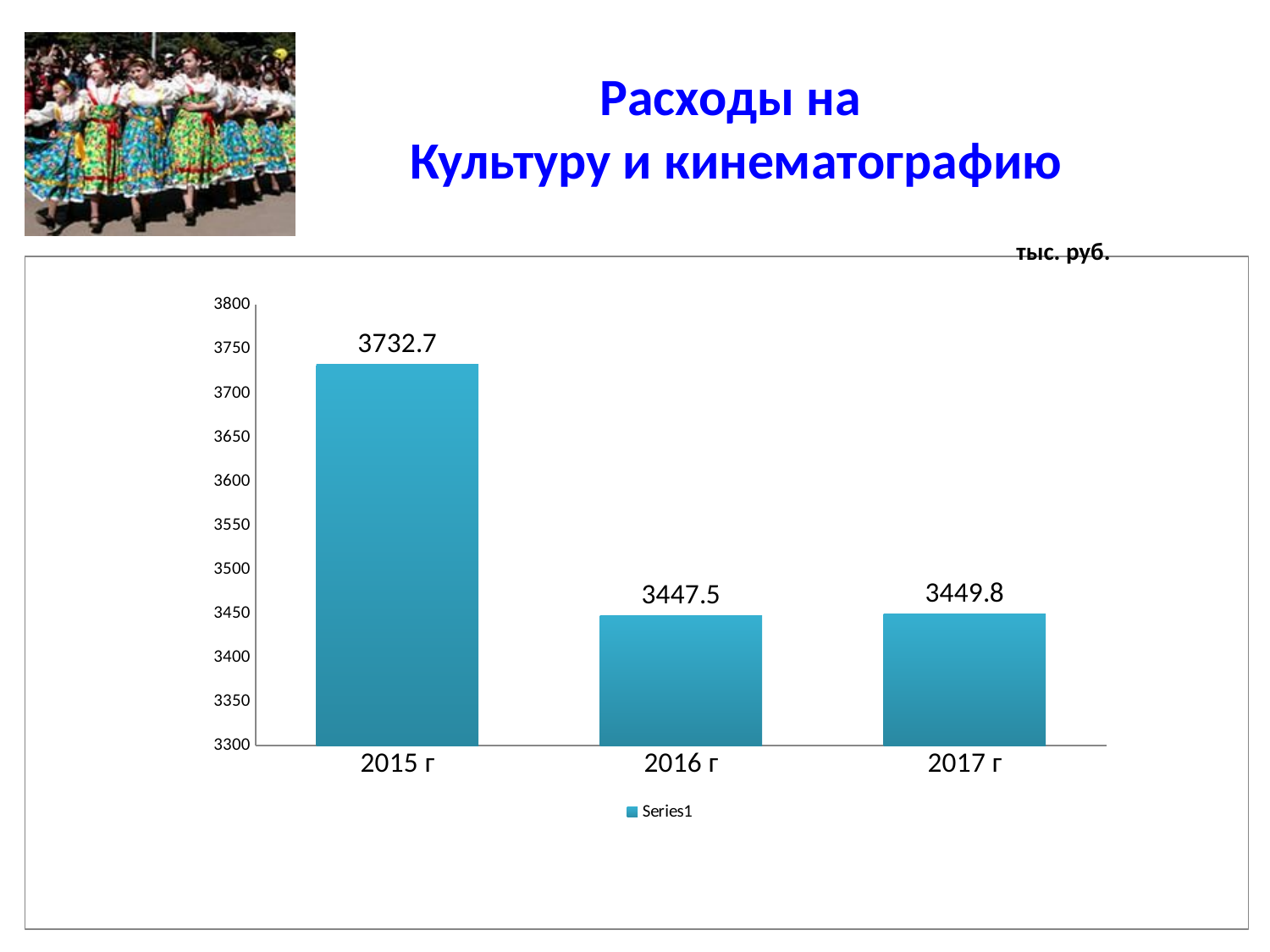
Which is larger, the value for 2016 г or the value for 2017 г? 2017 г Which year has the highest value? 2015 г What is the value for 2016 г? 3447.5 What kind of chart is shown on the slide? bar chart How many years are shown on the x axis? 3 What is the difference between the values for 2015 г and 2016 г? 285.2 Is the value for 2015 г greater or less than 3700? greater What unit is indicated above the chart? тыс. руб. What is the value for 2017 г? 3449.8 What is the difference between the values for 2017 г and 2016 г? 2.3 Which year has the lowest value? 2016 г What is the value for 2015 г? 3732.7